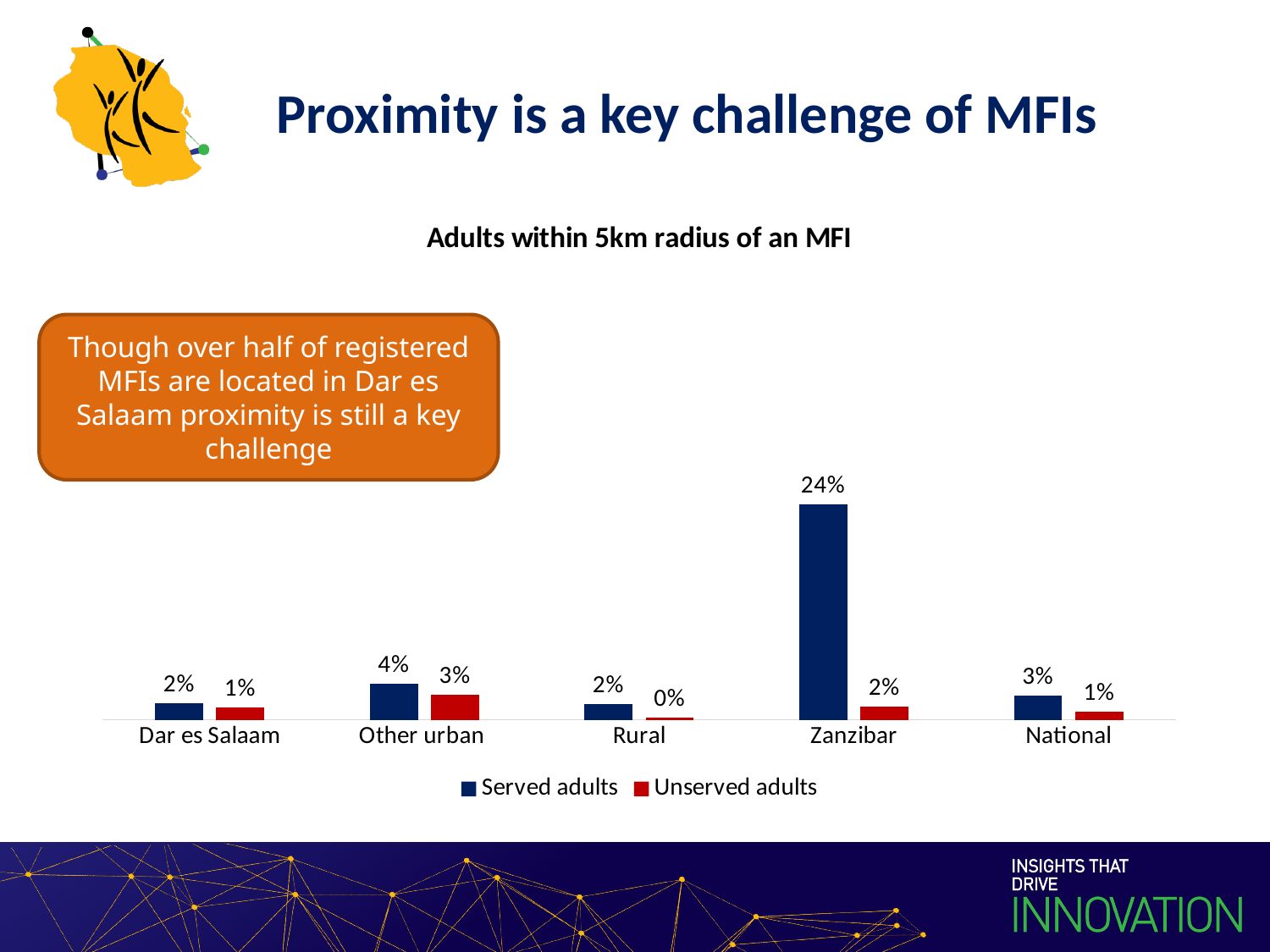
What is the title of the chart? Adults within 5km radius of an MFI What is the value for Served adults at the National level? 3% Which category has the lowest value for Unserved adults? Rural What is the value for Unserved adults in Rural? 0% What is the value for Served adults in Zanzibar? 24% What is the difference between Served adults and Unserved adults in Zanzibar? 22% What is the value for Unserved adults in Other urban? 3% What kind of chart is shown on the slide? Bar chart Which category has the highest value for Served adults? Zanzibar How many series does the legend list? 2 How many categories are shown on the x axis? 5 Which is larger in Other urban: Served adults or Unserved adults? Served adults